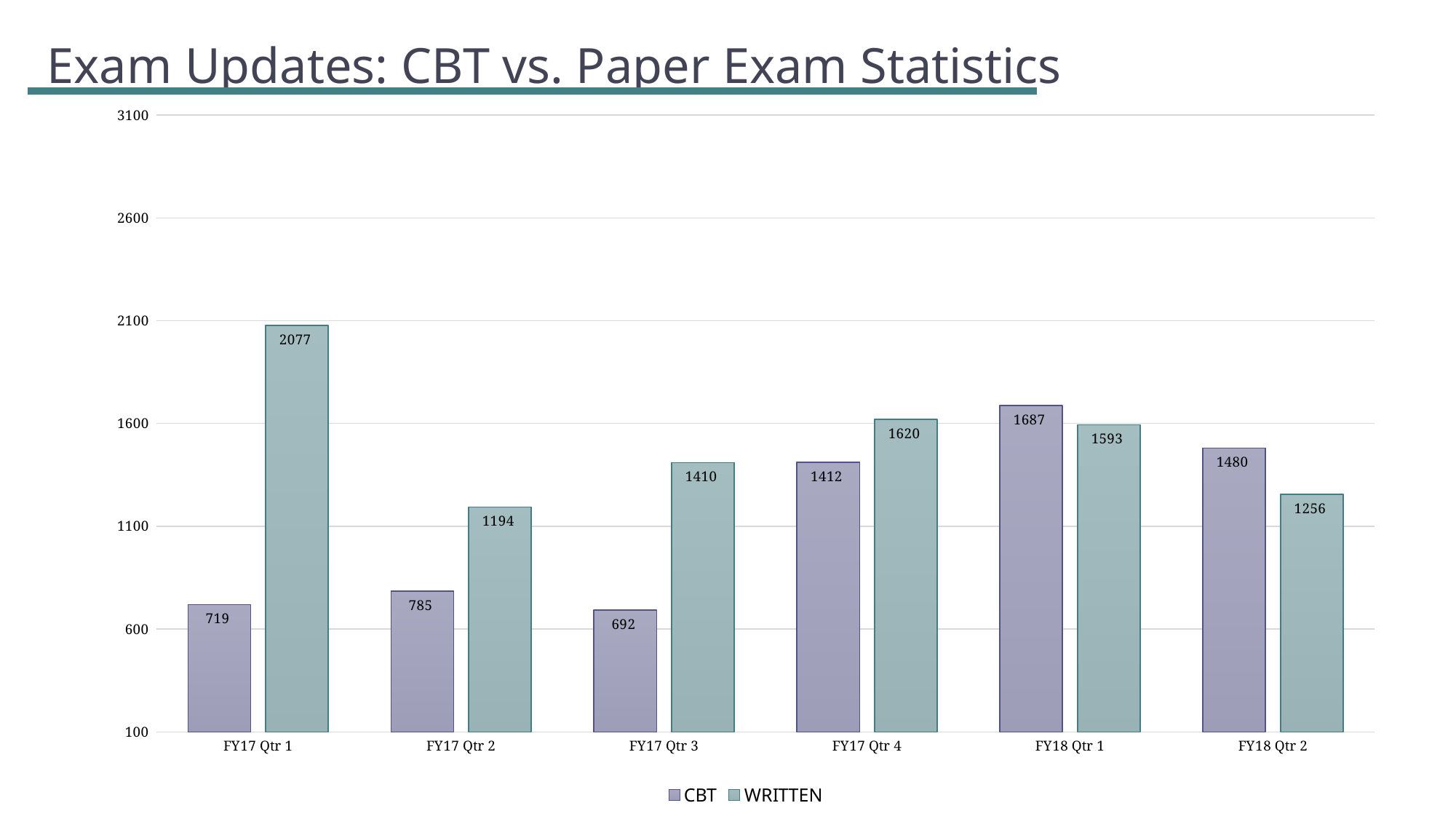
What is the CBT value for FY17 Qtr 1? 719 How many series does the legend list? 2 How many quarters are shown on the x axis? 6 What is the WRITTEN value for FY17 Qtr 4? 1620 What kind of chart is shown on the slide? bar chart Is the WRITTEN value for FY17 Qtr 2 greater or less than 1100? greater Which quarter has the highest WRITTEN value? FY17 Qtr 1 Which is larger in FY18 Qtr 1, the CBT value or the WRITTEN value? CBT What is the CBT value for FY18 Qtr 2? 1480 What is the difference between the WRITTEN and CBT values for FY17 Qtr 1? 1358 Which quarter has the lowest CBT value? FY17 Qtr 3 What is the title of the slide? Exam Updates: CBT vs. Paper Exam Statistics